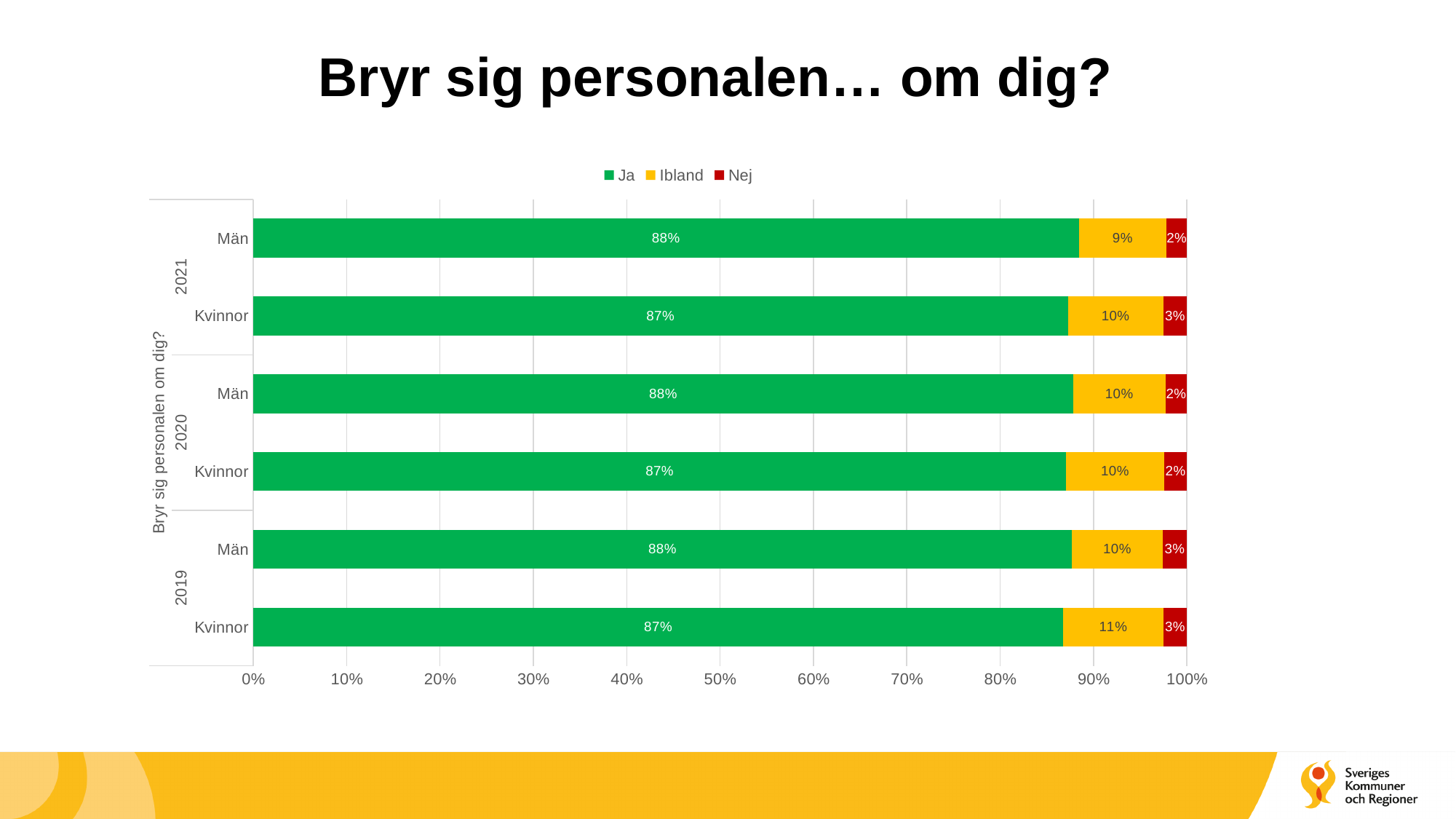
What is the 'Nej' value for Kvinnor in 2020? 2% What is the 'Ibland' value for Kvinnor in 2019? 11% What is the 'Ja' value for Män in 2021? 88% What is the 'Ibland' value for Män in 2020? 10% How many bars are plotted in the chart? 6 Which is larger: the 'Ibland' value for Kvinnor in 2019 or the 'Ibland' value for Män in 2021? Kvinnor in 2019 What kind of chart is shown on the slide? Stacked bar chart What is the 'Nej' value for Kvinnor in 2021? 3% Which series is shown in green in the legend? Ja What is the title of the slide? Bryr sig personalen… om dig? What is the difference between the 'Ja' value for Män in 2019 and the 'Ja' value for Kvinnor in 2019? 1% How many series does the legend list? 3